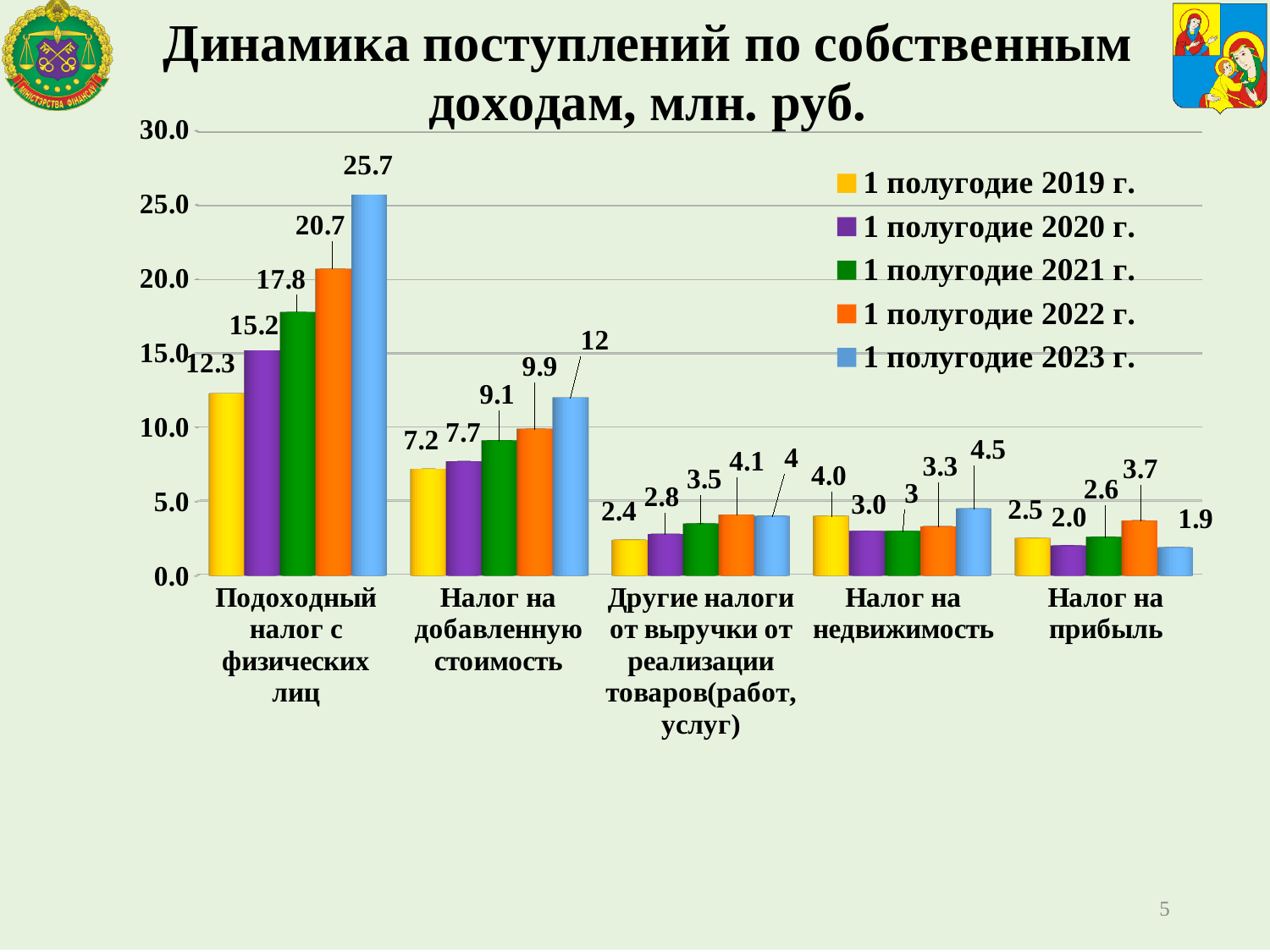
What is the value for 'Подоходный налог с физических лиц' in the series '1 полугодие 2023 г.'? 25.7 How many categories are shown on the x axis? 5 What kind of chart is shown on the slide? bar chart Which category has the highest value in the series '1 полугодие 2019 г.'? Подоходный налог с физических лиц Which category has the lowest value in the series '1 полугодие 2023 г.'? Налог на прибыль What is the value for 'Налог на прибыль' in the series '1 полугодие 2022 г.'? 3.7 Is the value for 'Налог на добавленную стоимость' in '1 полугодие 2022 г.' greater or less than 10.0? less What is the title of the chart? Динамика поступлений по собственным доходам, млн. руб. What is the difference between the '1 полугодие 2023 г.' and '1 полугодие 2019 г.' values for 'Подоходный налог с физических лиц'? 13.4 Which is larger for 'Налог на недвижимость': the value for '1 полугодие 2019 г.' or for '1 полугодие 2022 г.'? 1 полугодие 2019 г. What is the value for 'Налог на добавленную стоимость' in the series '1 полугодие 2021 г.'? 9.1 How many series does the legend list? 5